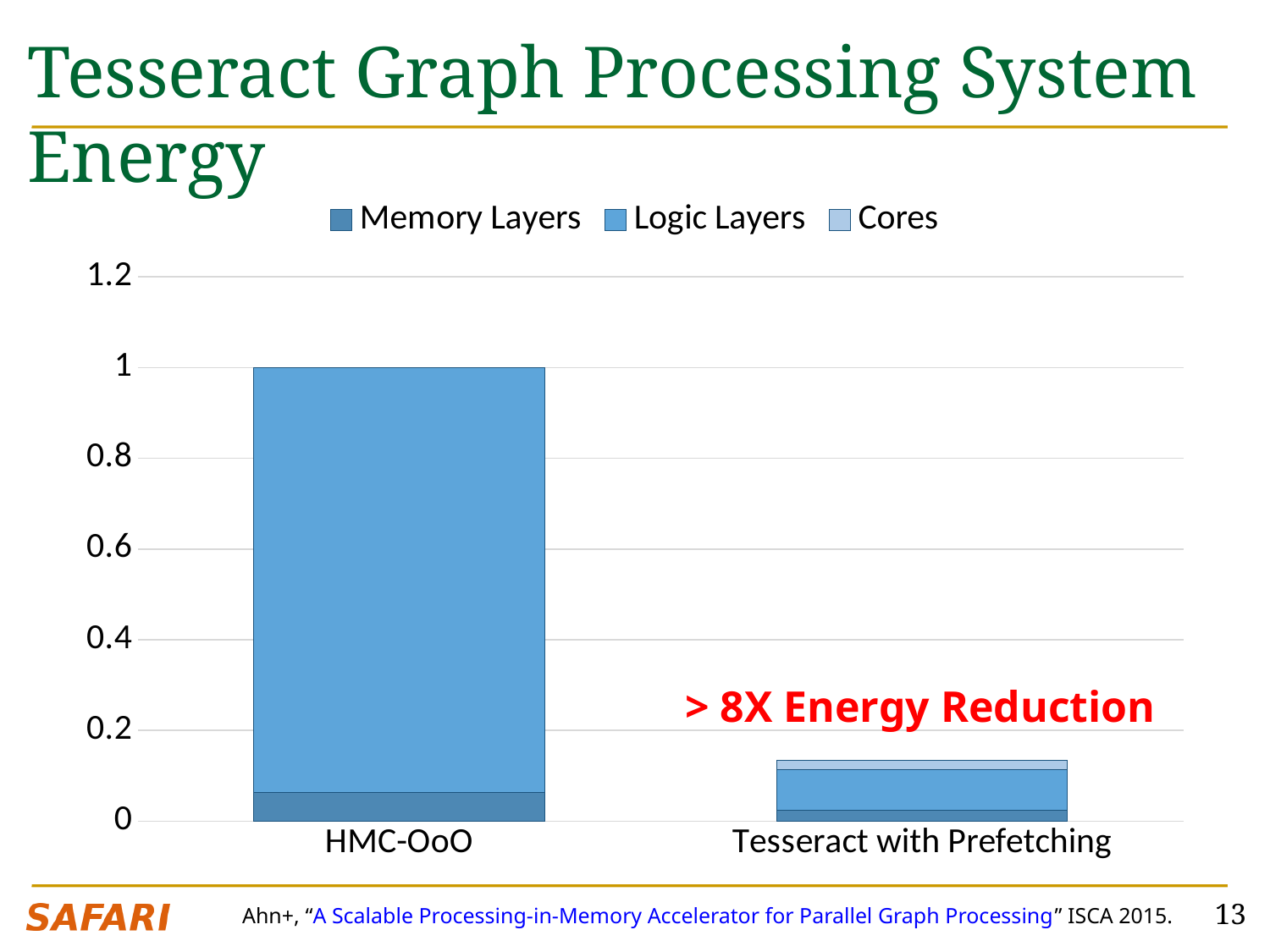
Is the total value for Tesseract with Prefetching greater or less than 0.2? less Which is larger, the total for HMC-OoO or the total for Tesseract with Prefetching? HMC-OoO Is the total value for HMC-OoO greater or less than 0.8? greater How many categories are shown on the x axis? 2 Which category has the lowest total energy? Tesseract with Prefetching How many series does the legend list? 3 What kind of chart is shown on the slide? stacked bar chart What is the total height of the HMC-OoO stacked bar? 1 Which category has the highest total energy? HMC-OoO What energy reduction does the red annotation on the chart claim? > 8X Energy Reduction Which series are listed in the legend? Memory Layers, Logic Layers, Cores Do the total values rise or fall from left to right along the x axis? fall